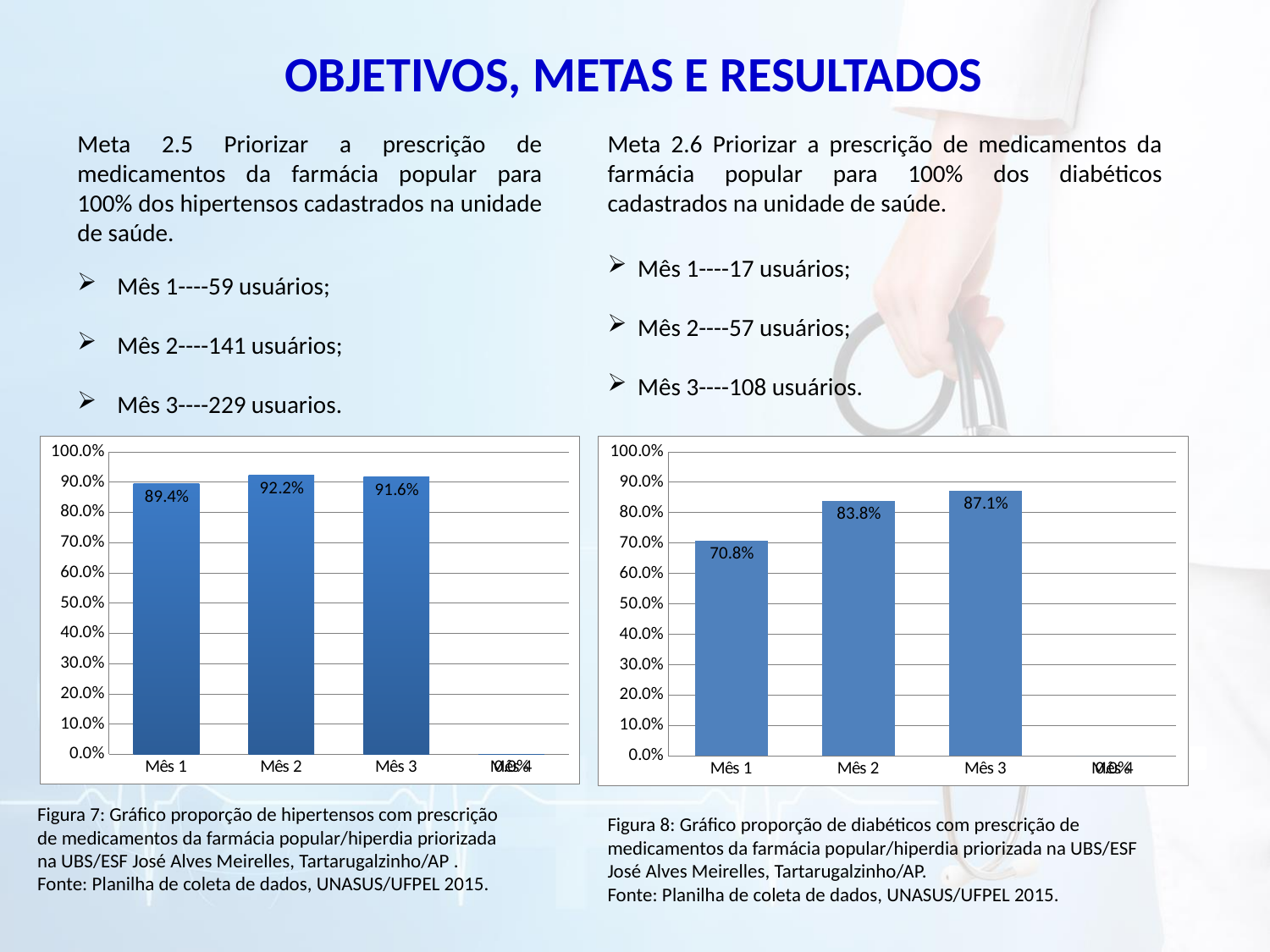
In the left chart (Figura 7, hipertensos), what is the value for Mês 2? 92.2% In the right chart (Figura 8, diabéticos), among Mês 1, Mês 2 and Mês 3, which has the lowest value? Mês 1 In the right chart (Figura 8, diabéticos), which month has the highest value? Mês 3 In the right chart (Figura 8, diabéticos), which is larger, the value for Mês 2 or the value for Mês 3? Mês 3 In the right chart (Figura 8, diabéticos), what is the value for Mês 3? 87.1% In the right chart (Figura 8, diabéticos), what is the value for Mês 1? 70.8% In the left chart (Figura 7, hipertensos), what is the difference between the values for Mês 2 and Mês 1? 2.8 percentage points In the right chart (Figura 8, diabéticos), what is the difference between the values for Mês 3 and Mês 1? 16.3 percentage points In the left chart (Figura 7, hipertensos), which month has the highest value? Mês 2 In the right chart (Figura 8, diabéticos), do the values rise or fall from Mês 1 to Mês 3? rise What kind of chart is the left chart (Figura 7, hipertensos)? bar chart In the left chart (Figura 7, hipertensos), what is the value for Mês 1? 89.4%